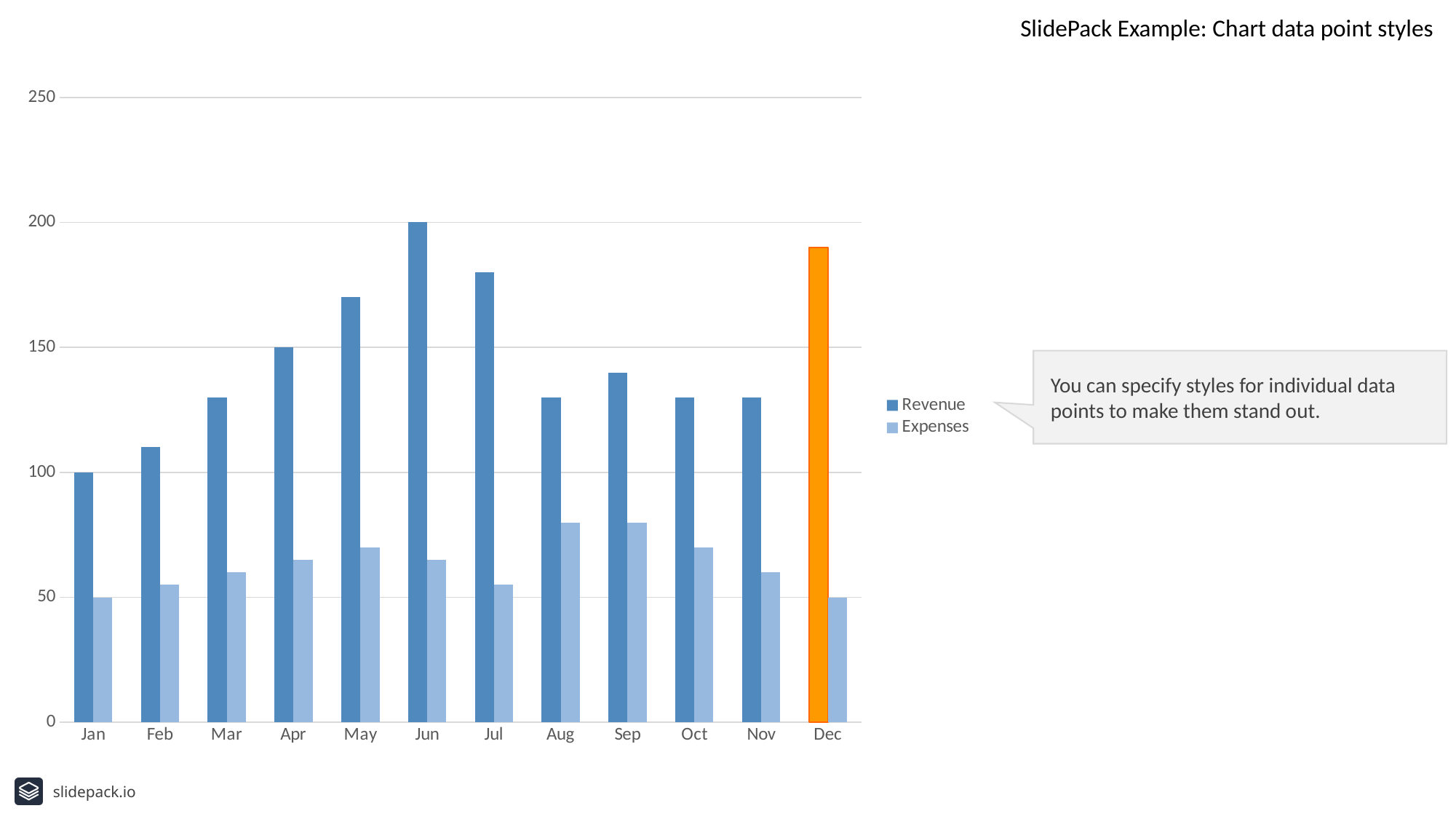
Is the Expenses value for Jul greater or less than 100? less Which month has the lowest Revenue? Jan What kind of chart is shown on the slide? bar chart Which month has the highest Revenue? Jun Which data point is highlighted in orange? Dec Revenue What is the difference between the Revenue for Jun and the Revenue for Jan? 100 What is the Revenue value for Jan? 100 Is the Revenue value for Dec greater or less than 150? greater How many months are shown on the x axis? 12 What is the Revenue value for Jun? 200 How many series does the legend list? 2 Which is larger, the Revenue for Jun or the Revenue for Jul? Jun